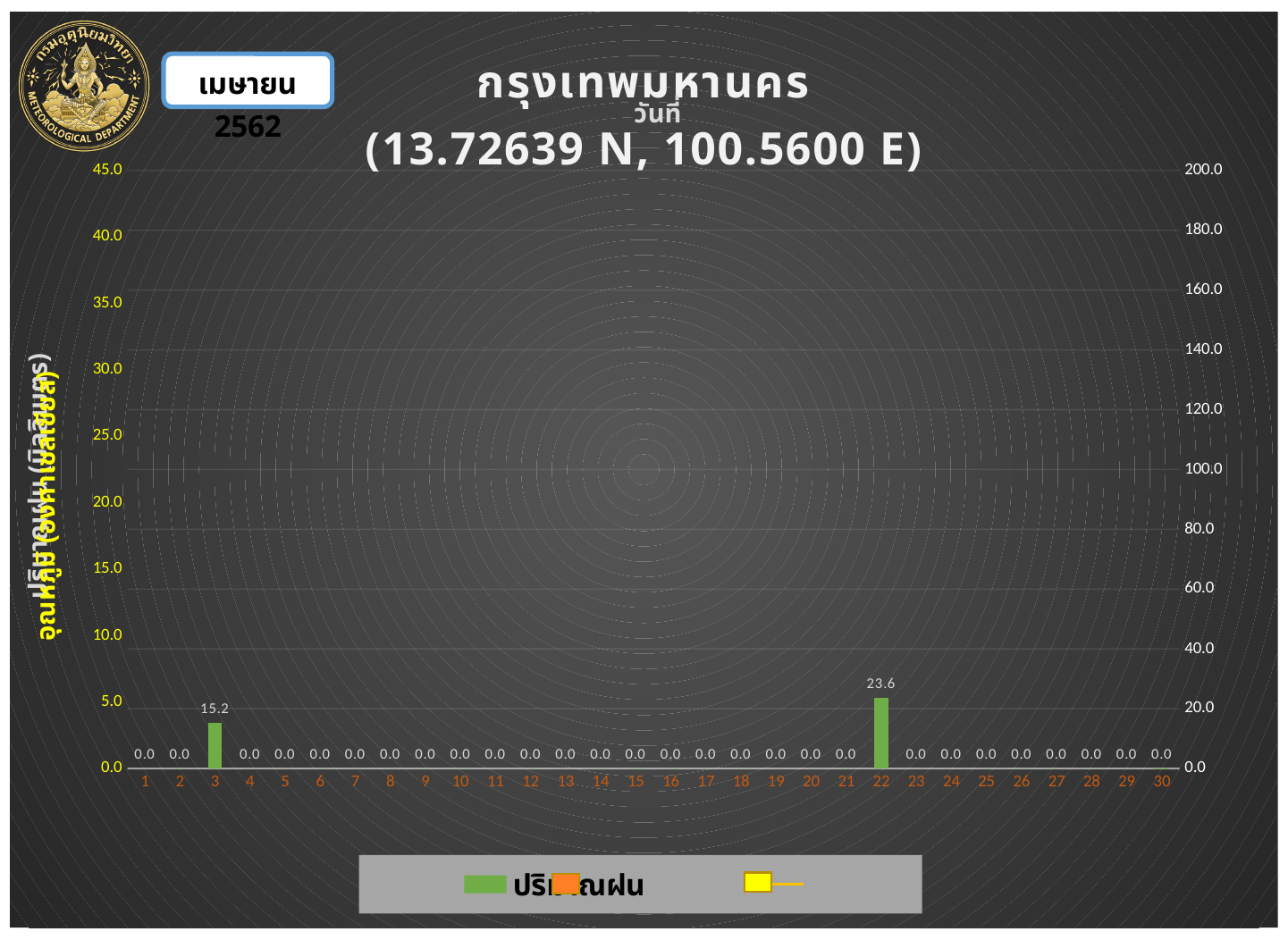
How many days are shown on the x axis? 30 What is the value shown for day 10? 0.0 What is the value shown for day 22? 23.6 What is the title of the chart? กรุงเทพมหานคร (13.72639 N, 100.5600 E) What is the value shown for day 1? 0.0 What does the green legend entry represent? ปริมาณฝน Which is larger, the value for day 3 or the value for day 22? day 22 Is the value for day 22 greater or less than 20.0? greater What is the difference between the values for day 22 and day 3? 8.4 What is the value shown for day 3? 15.2 Which day has the highest value? 22 What kind of chart is this? bar chart